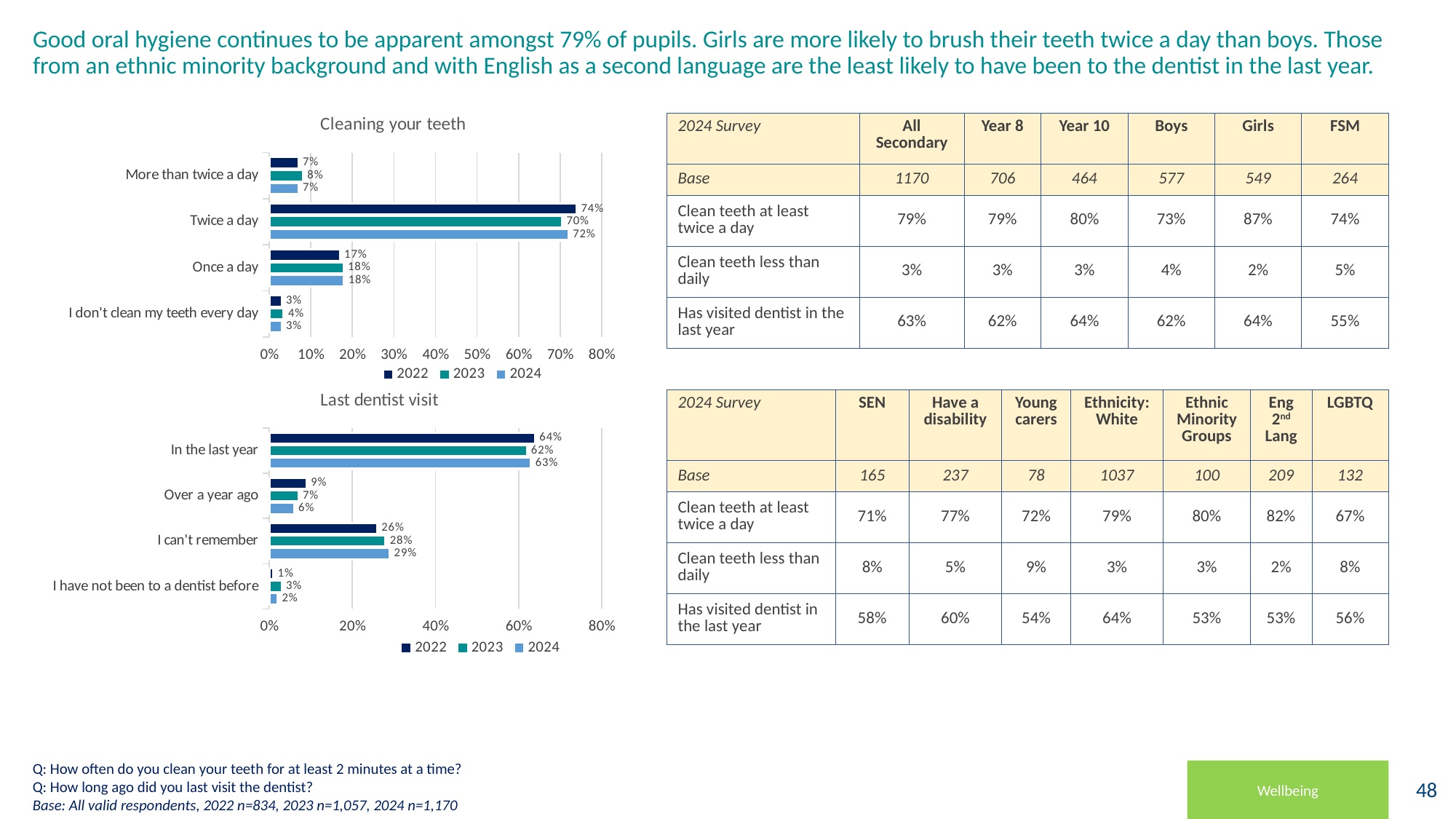
In the 'Last dentist visit' chart, which category has the lowest value in 2022? I have not been to a dentist before In the 'Last dentist visit' chart, what is the difference between the 2024 and 2022 values for 'I can't remember'? 3% In the 'Cleaning your teeth' chart, what is the 2022 value for 'Once a day'? 17% In the 'Cleaning your teeth' chart, which category has the highest value in 2023? Twice a day In the 'Cleaning your teeth' chart, what is the 2024 value for 'Twice a day'? 72% In the 'Cleaning your teeth' chart, how many categories are shown? 4 In the 'Last dentist visit' chart, is the 2023 value for 'In the last year' larger or smaller than the 2024 value? smaller In the 'Last dentist visit' chart, what is the 2024 value for 'I can't remember'? 29% In the 'Cleaning your teeth' chart, what is the difference between the 2022 and 2023 values for 'Twice a day'? 4% In the 'Cleaning your teeth' chart, how many series does the legend list? 3 What kind of chart is the 'Last dentist visit' chart? Bar chart In the 'Last dentist visit' chart, what is the 2022 value for 'Over a year ago'? 9%